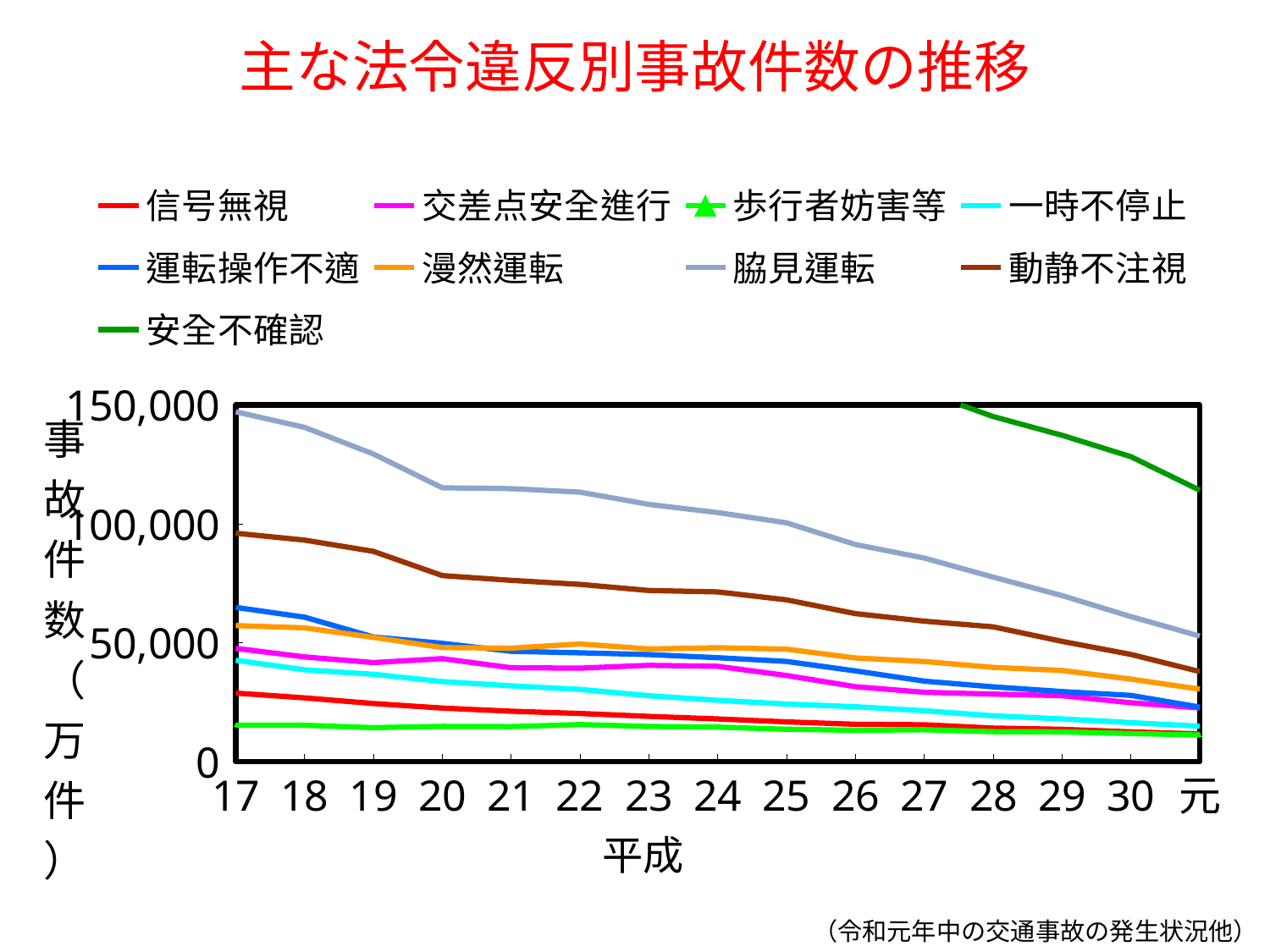
In year 17, which is larger: 運転操作不適 or 漫然運転? 運転操作不適 What is the title of the chart? 主な法令違反別事故件数の推移 How many points are on the x axis of the chart? 15 Is the value for 信号無視 in year 17 greater or less than 50,000? less Is the value for 安全不確認 in year 元 greater or less than 100,000? greater Is the value for 脇見運転 in year 17 greater or less than 100,000? greater How many series does the legend list? 9 Do the values for 脇見運転 rise or fall from year 17 to year 元? fall What is the label of the x axis? 平成 Which series has the lowest value in year 17? 歩行者妨害等 Which series has the highest value in year 元? 安全不確認 What kind of chart is shown on the slide? line chart